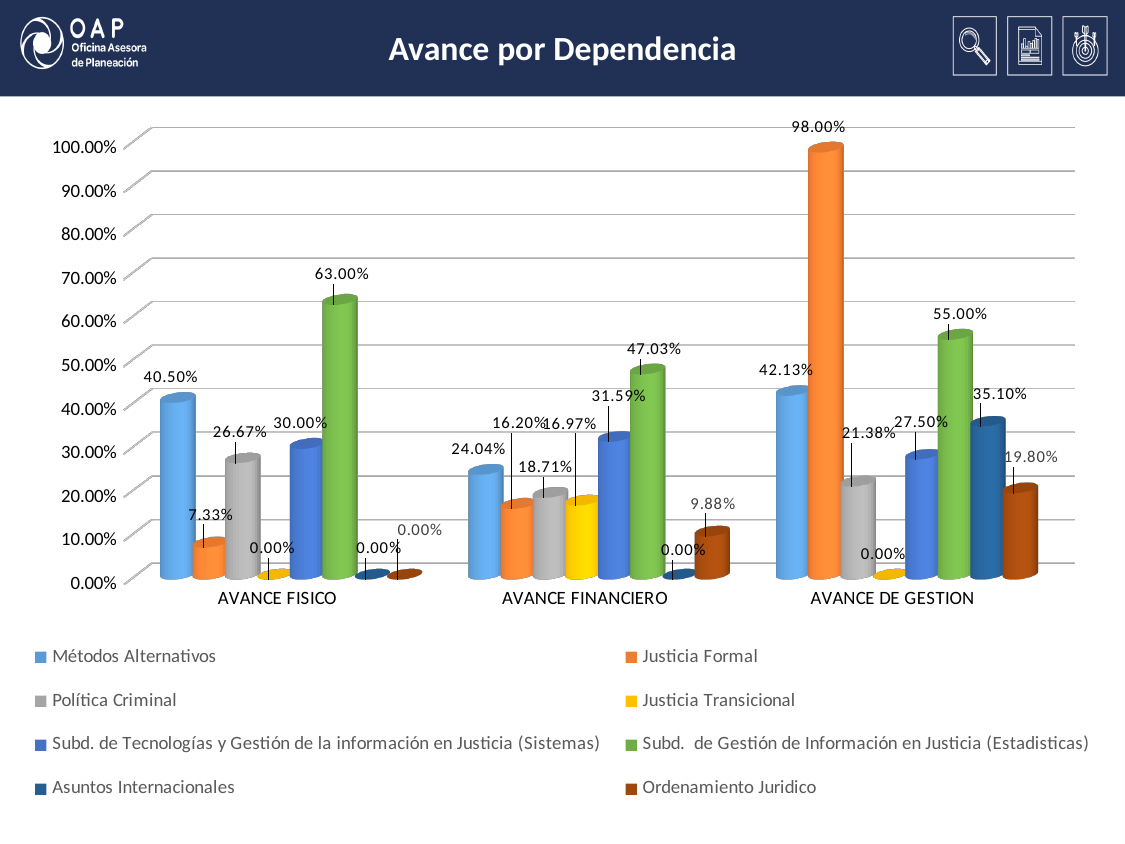
What type of chart is shown on the slide? bar chart What is the title of the chart? Avance por Dependencia What is the value for Subd. de Gestión de Información en Justicia (Estadisticas) in AVANCE FISICO? 63.00% What is the value for Métodos Alternativos in AVANCE FINANCIERO? 24.04% What is the value for Justicia Formal in AVANCE DE GESTION? 98.00% How many categories are shown on the x axis? 3 What is the difference between the Métodos Alternativos values in AVANCE DE GESTION and AVANCE FISICO? 1.63% Which series has the highest value in AVANCE DE GESTION? Justicia Formal Which series has the highest value in AVANCE FINANCIERO? Subd. de Gestión de Información en Justicia (Estadisticas) How many series does the legend list? 8 What is the value for Ordenamiento Juridico in AVANCE DE GESTION? 19.80% Which is larger: Política Criminal in AVANCE FISICO or Política Criminal in AVANCE DE GESTION? AVANCE FISICO